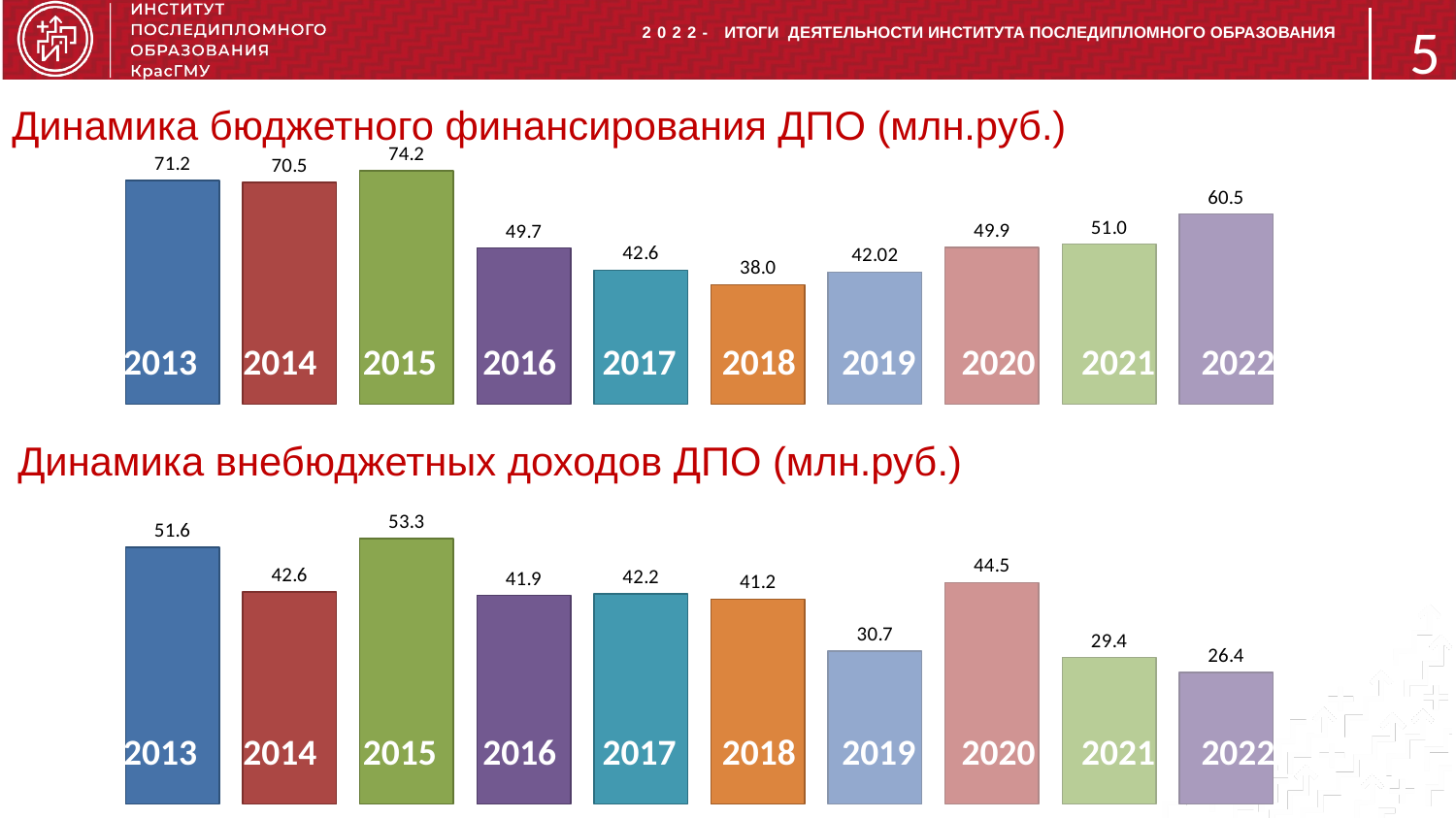
In the bottom chart (Динамика внебюджетных доходов ДПО), which year has the lowest value? 2022 In the top chart (Динамика бюджетного финансирования ДПО), which year has the highest value? 2015 What type of chart is the bottom chart (Динамика внебюджетных доходов ДПО)? bar chart In the bottom chart (Динамика внебюджетных доходов ДПО), what is the difference between the values for 2013 and 2014? 9.0 In the top chart (Динамика бюджетного финансирования ДПО), what is the difference between the values for 2022 and 2021? 9.5 In the top chart (Динамика бюджетного финансирования ДПО), what is the value for 2015? 74.2 In the bottom chart (Динамика внебюджетных доходов ДПО), which is larger, the value for 2019 or the value for 2021? 2019 In the bottom chart (Динамика внебюджетных доходов ДПО), which year has the highest value? 2015 In the bottom chart (Динамика внебюджетных доходов ДПО), what is the value for 2020? 44.5 In the top chart (Динамика бюджетного финансирования ДПО), what is the value for 2019? 42.02 In the top chart (Динамика бюджетного финансирования ДПО), how many years are shown? 10 In the top chart (Динамика бюджетного финансирования ДПО), which year has the lowest value? 2018